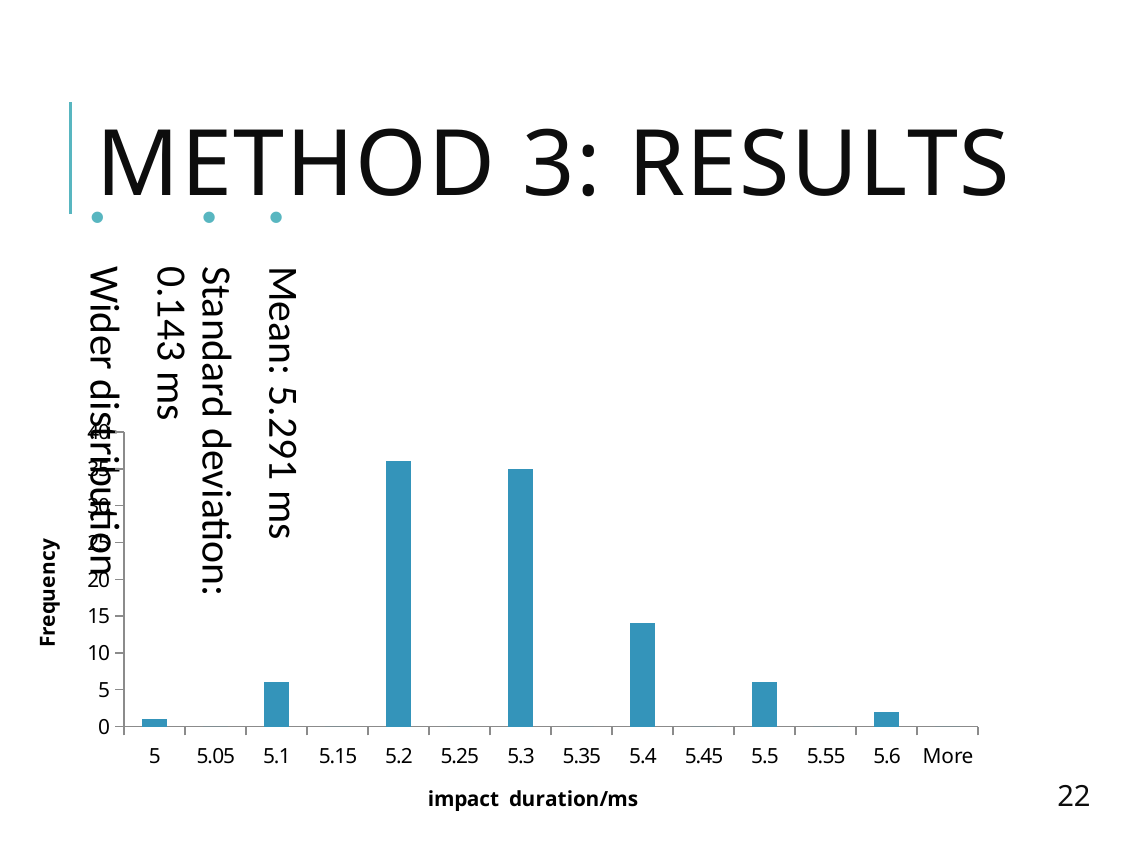
Which has the higher frequency, impact duration 5.1 or 5.6? 5.1 Is the frequency for impact duration 5.6 greater or less than 5? less Is the frequency for impact duration 5.2 greater or less than 30? greater Is the frequency for impact duration 5.1 greater or less than 10? less Which has the higher frequency, impact duration 5.4 or 5.5? 5.4 What is the label of the y axis of the chart? Frequency Which has the higher frequency, impact duration 5.2 or 5.4? 5.2 What is the label of the x axis of the chart? impact duration/ms How many categories are labelled along the x axis of the chart? 14 What kind of chart is shown on the slide? bar chart